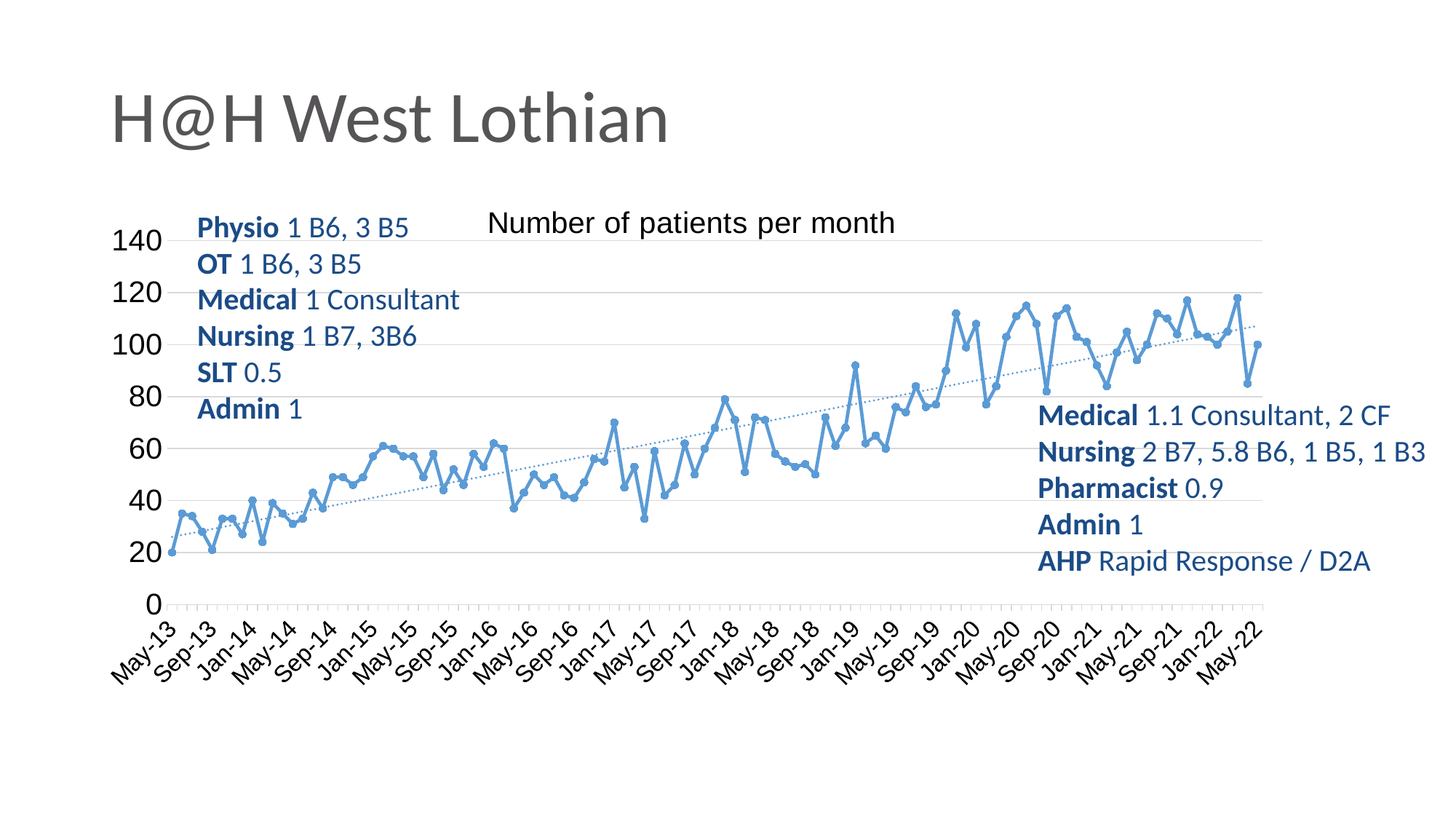
What is the title of the chart? Number of patients per month Overall, do the values rise or fall from May-13 to May-22? rise Which is larger, the value for Jan-17 or the value for May-17? Jan-17 Is the value for May-17 greater or less than 40? greater Is the value for May-13 greater or less than 40? less Is the value for Jan-19 greater or less than 80? greater What is the highest value shown on the vertical axis? 140 What kind of chart is shown on the slide? line chart